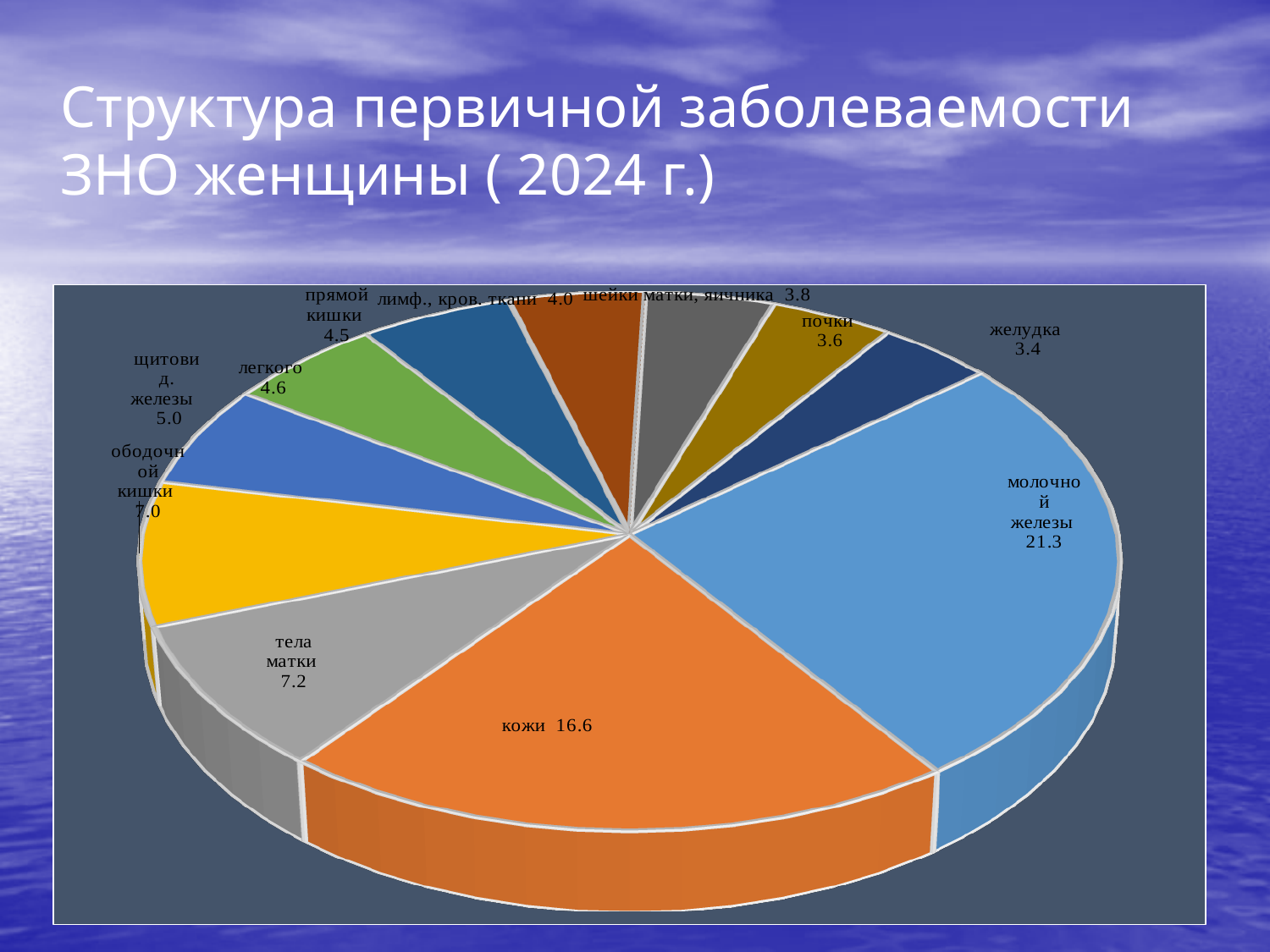
What is the value for легкого? 4.6 What is the value for тела матки? 7.2 Which category has the largest slice of the pie? молочной железы What is the title of the slide containing the chart? Структура первичной заболеваемости ЗНО женщины ( 2024 г.) What is the value for кожи? 16.6 What kind of chart is shown on the slide? pie chart What is the value for ободочной кишки? 7.0 What is the difference between the values for щитовид. железы and почки? 1.4 What is the value for желудка? 3.4 What is the value for молочной железы? 21.3 Which is larger, the value for прямой кишки or the value for лимф., кров. ткани? прямой кишки What is the difference between the values for молочной железы and кожи? 4.7